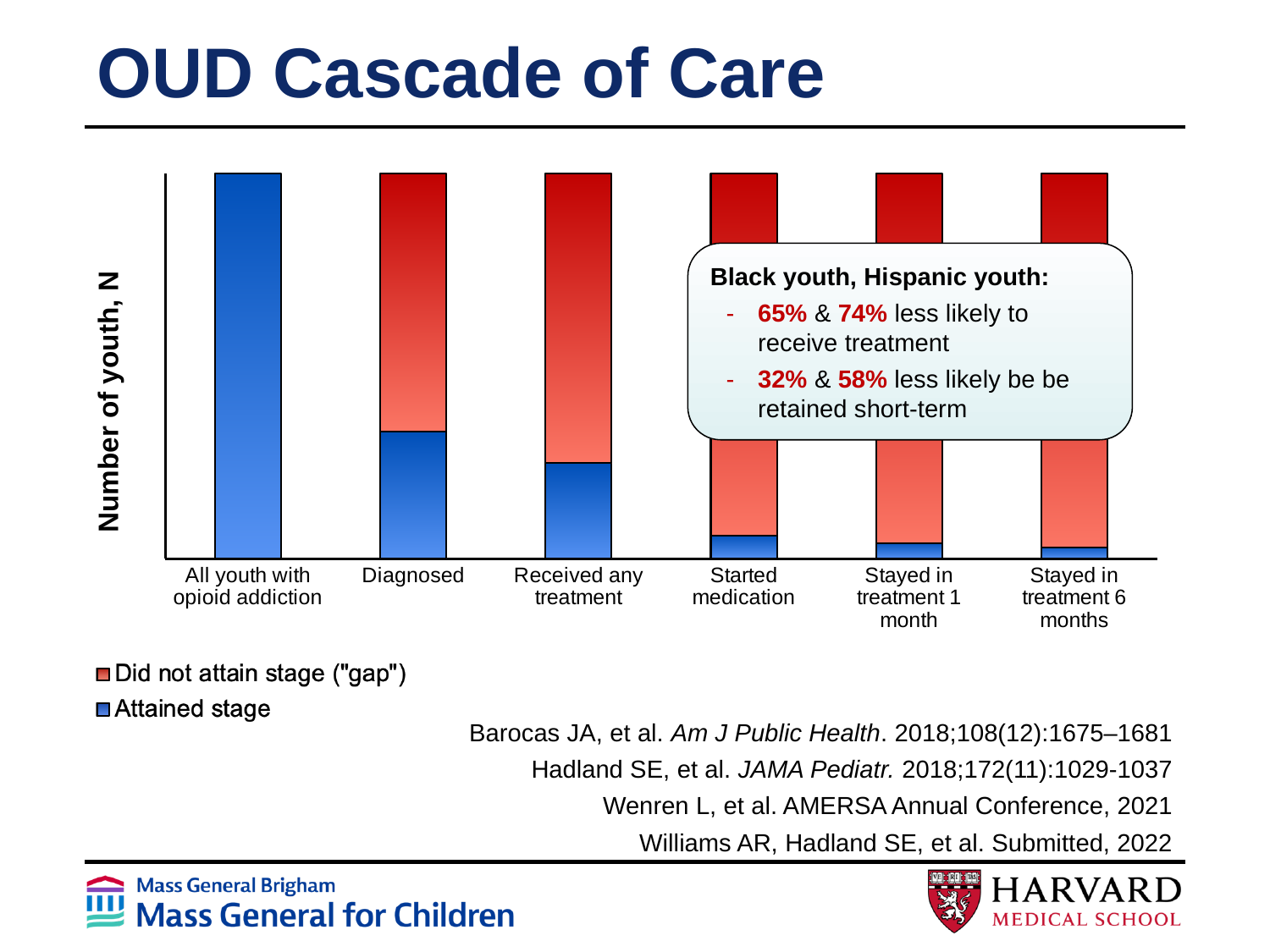
Which series is shown in blue in the chart? Attained stage Which stage has the larger 'Did not attain stage ("gap")' portion, Diagnosed or Started medication? Started medication How many series does the chart's legend list? 2 Which stage has the smallest 'Attained stage' portion? Stayed in treatment 6 months How many stages (categories) are shown along the x axis of the chart? 6 Which stage has the larger 'Attained stage' portion, Diagnosed or Received any treatment? Diagnosed Which stage has the largest 'Attained stage' portion? All youth with opioid addiction Does the 'Did not attain stage ("gap")' portion rise or fall moving from left to right along the x axis? Rise What is the label of the chart's y axis? Number of youth, N Does the 'Attained stage' portion rise or fall moving from left to right along the x axis? Fall What kind of chart is shown on the slide? Stacked bar chart